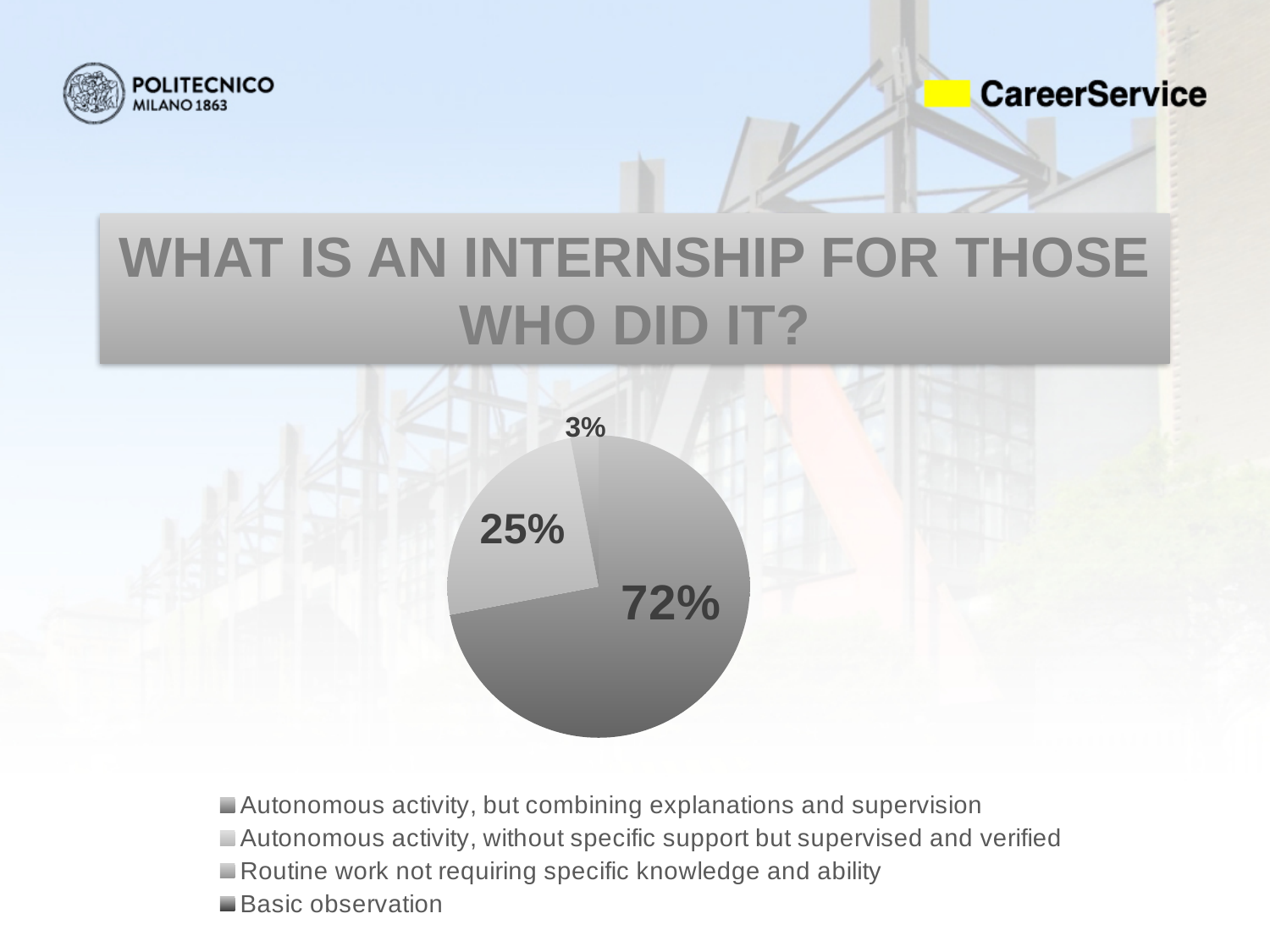
What kind of chart is shown on the slide? pie chart How many entries does the legend list? 4 What is the difference between the largest slice (72%) and the 25% slice? 47% What share of the pie is labelled for 'Autonomous activity, without specific support but supervised and verified'? 25% What is the smallest share labelled in the pie chart? 3% Which legend entry is listed last? Basic observation What is the title of the slide containing the pie chart? WHAT IS AN INTERNSHIP FOR THOSE WHO DID IT? What share of the pie is labelled for 'Autonomous activity, but combining explanations and supervision'? 72% Which is larger, the 25% slice or the 3% slice? the 25% slice What share of the pie is labelled for 'Routine work not requiring specific knowledge and ability'? 3% What is the largest share shown in the pie chart? 72% How many percentage labels are shown on the pie chart? 3